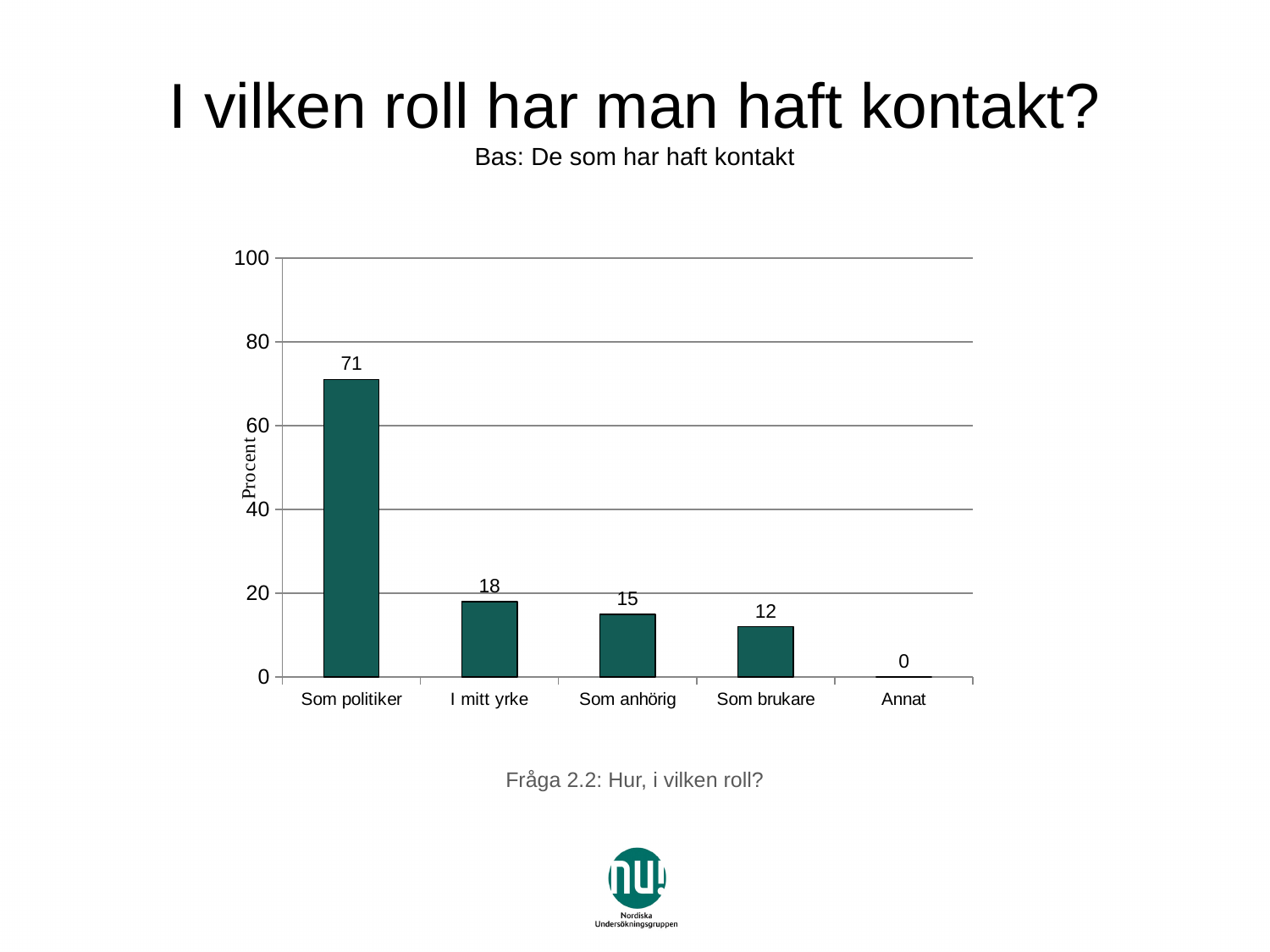
Which category has the highest value? Som politiker How many categories are shown on the x axis? 5 What kind of chart is shown on the slide? Bar chart Which is larger, the value for Som anhörig or the value for Som brukare? Som anhörig What is the value for Som anhörig? 15 What is the value for Som brukare? 12 What is the label of the vertical axis? Procent What is the difference between the values for Som politiker and I mitt yrke? 53 What is the value for Annat? 0 What is the value for I mitt yrke? 18 What is the value for Som politiker? 71 Which category has the lowest value? Annat